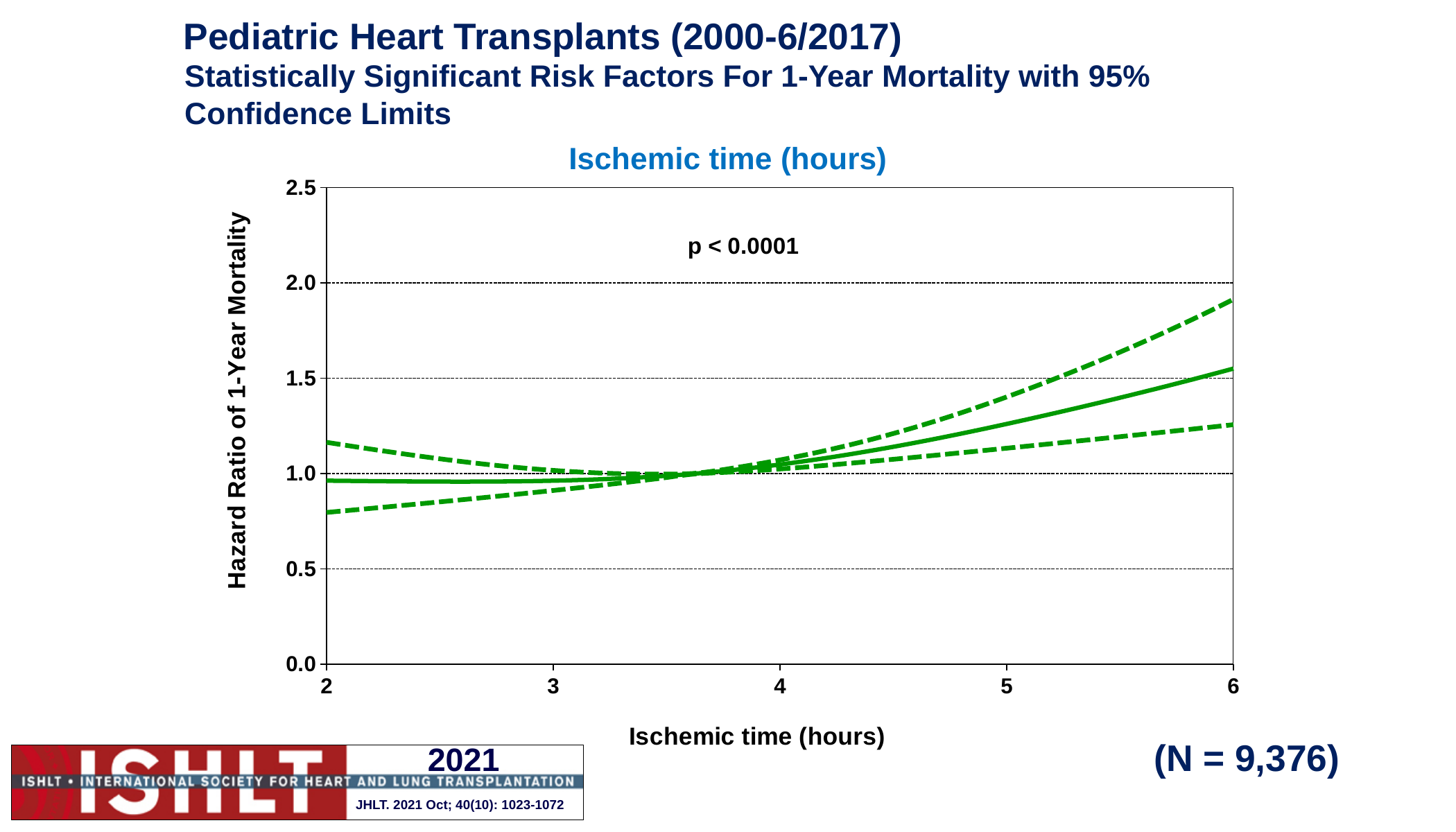
Is the lower dashed confidence limit at 2 hours greater or less than 1.0? less Is the lower dashed confidence limit at 6 hours greater or less than 1.5? less What sample size (N) is shown on the slide? N = 9,376 What kind of chart is shown on the slide? line chart How many lines are plotted on the chart? 3 Is the solid hazard ratio line at 6 hours greater or less than 2.0? less Does the solid hazard ratio line rise or fall as ischemic time increases from 4 to 6 hours? rise What p-value is printed on the chart? p < 0.0001